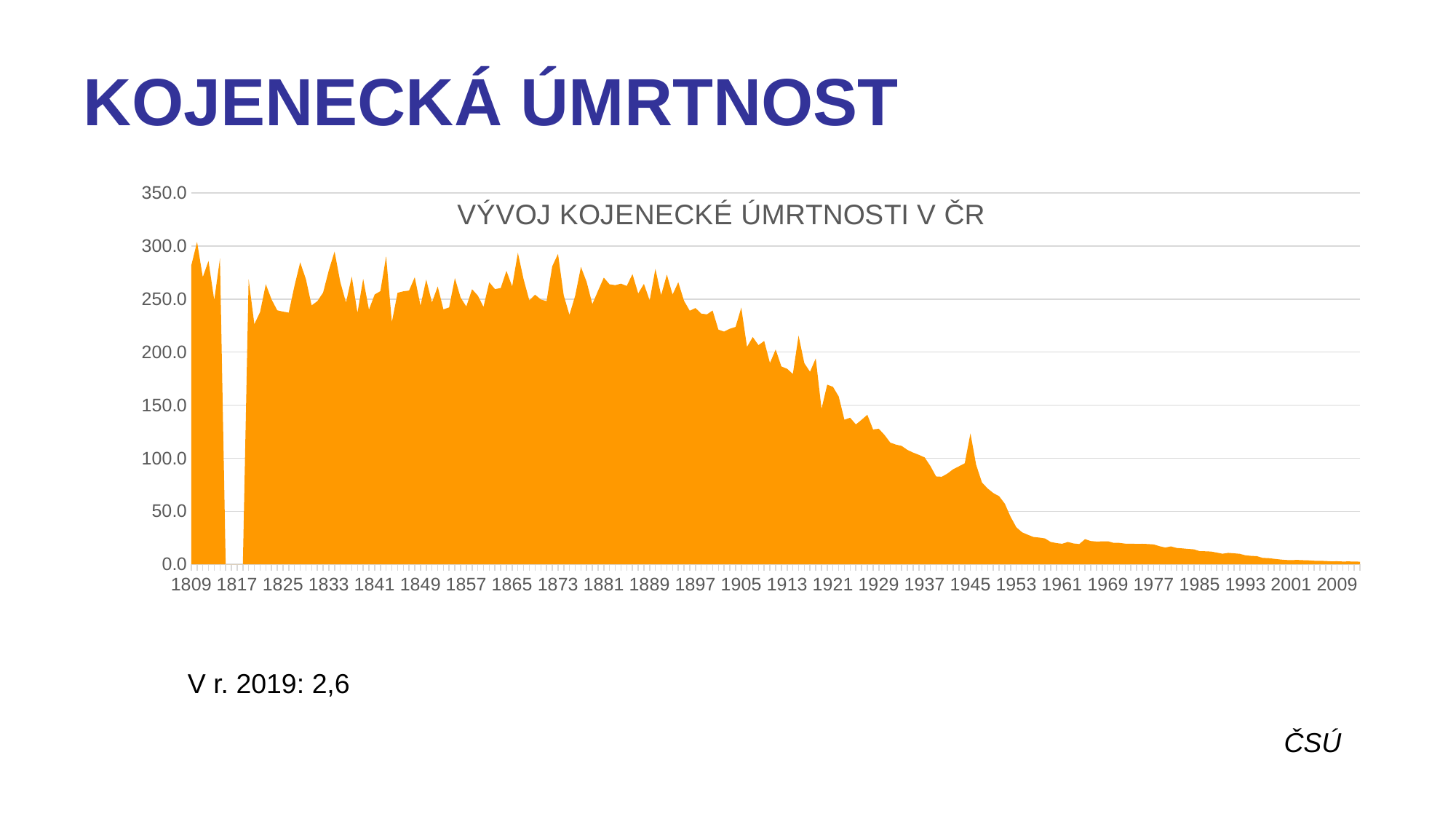
Which year has the larger value, 1809 or 2009? 1809 How many year labels are shown on the x axis? 26 Which year has the larger value, 1945 or 1961? 1945 Is the value for 1945 greater or less than 100? greater What kind of chart is shown on the slide? Area chart Overall, do the values rise or fall from 1809 to 2009 along the x axis? Fall Is the value for 1961 greater or less than 50? less What is the title of the chart? VÝVOJ KOJENECKÉ ÚMRTNOSTI V ČR What colour is the plotted area in the chart? Orange Is the value for 2009 greater or less than 50? less